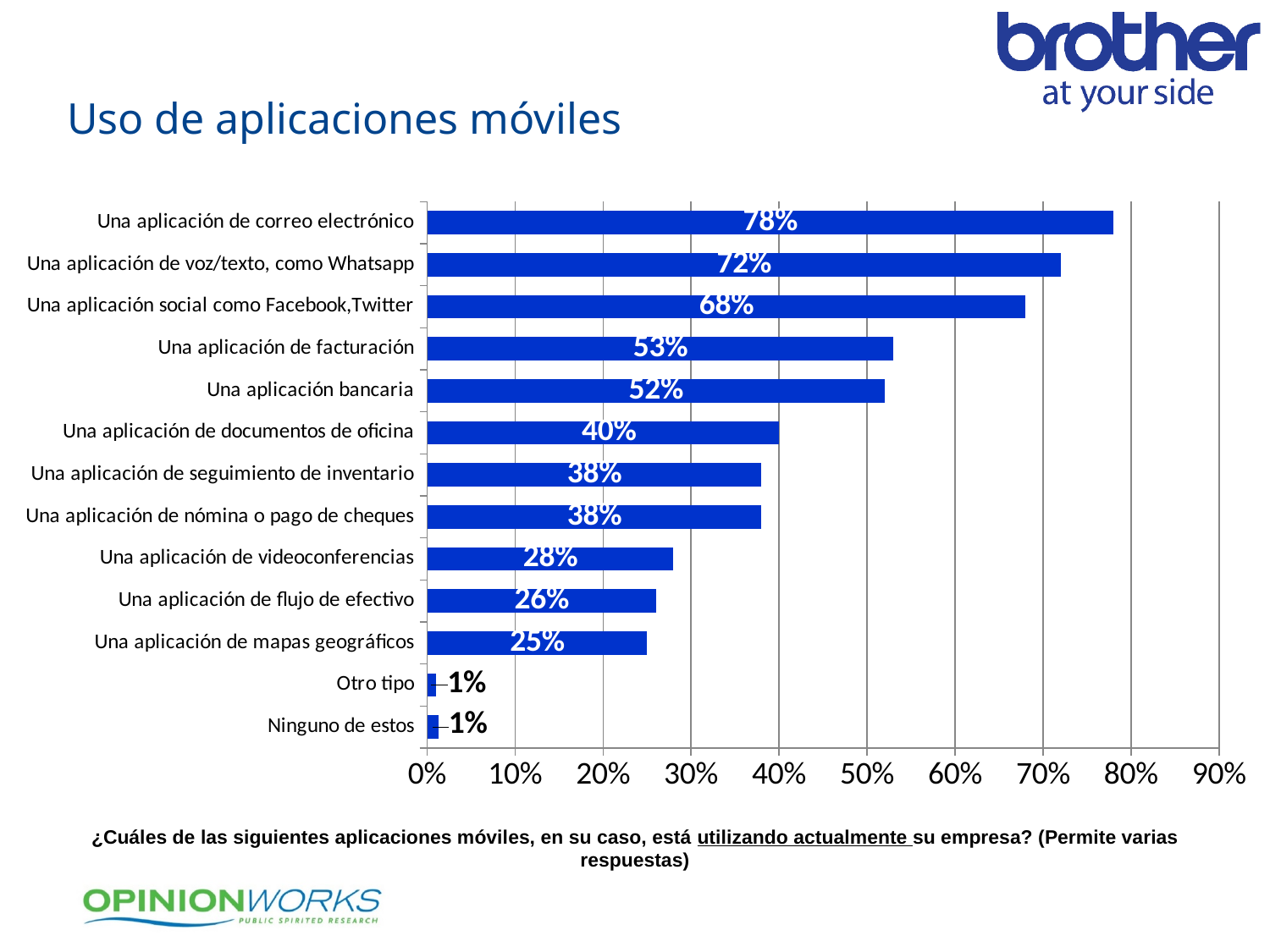
What is the value for "Una aplicación de correo electrónico"? 78% Which is larger: "Una aplicación de facturación" or "Una aplicación de documentos de oficina"? Una aplicación de facturación What is the title of the slide? Uso de aplicaciones móviles Is the value for "Una aplicación de videoconferencias" greater or less than 30%? less What is the difference between "Una aplicación de voz/texto, como Whatsapp" and "Una aplicación social como Facebook,Twitter"? 4% What kind of chart is shown on the slide? bar chart What is the value for "Una aplicación bancaria"? 52% What is the difference between "Una aplicación de correo electrónico" and "Una aplicación de flujo de efectivo"? 52% What is the value for "Una aplicación de mapas geográficos"? 25% What is the value for "Otro tipo"? 1% How many categories are shown in the chart? 13 Which category has the highest value? Una aplicación de correo electrónico